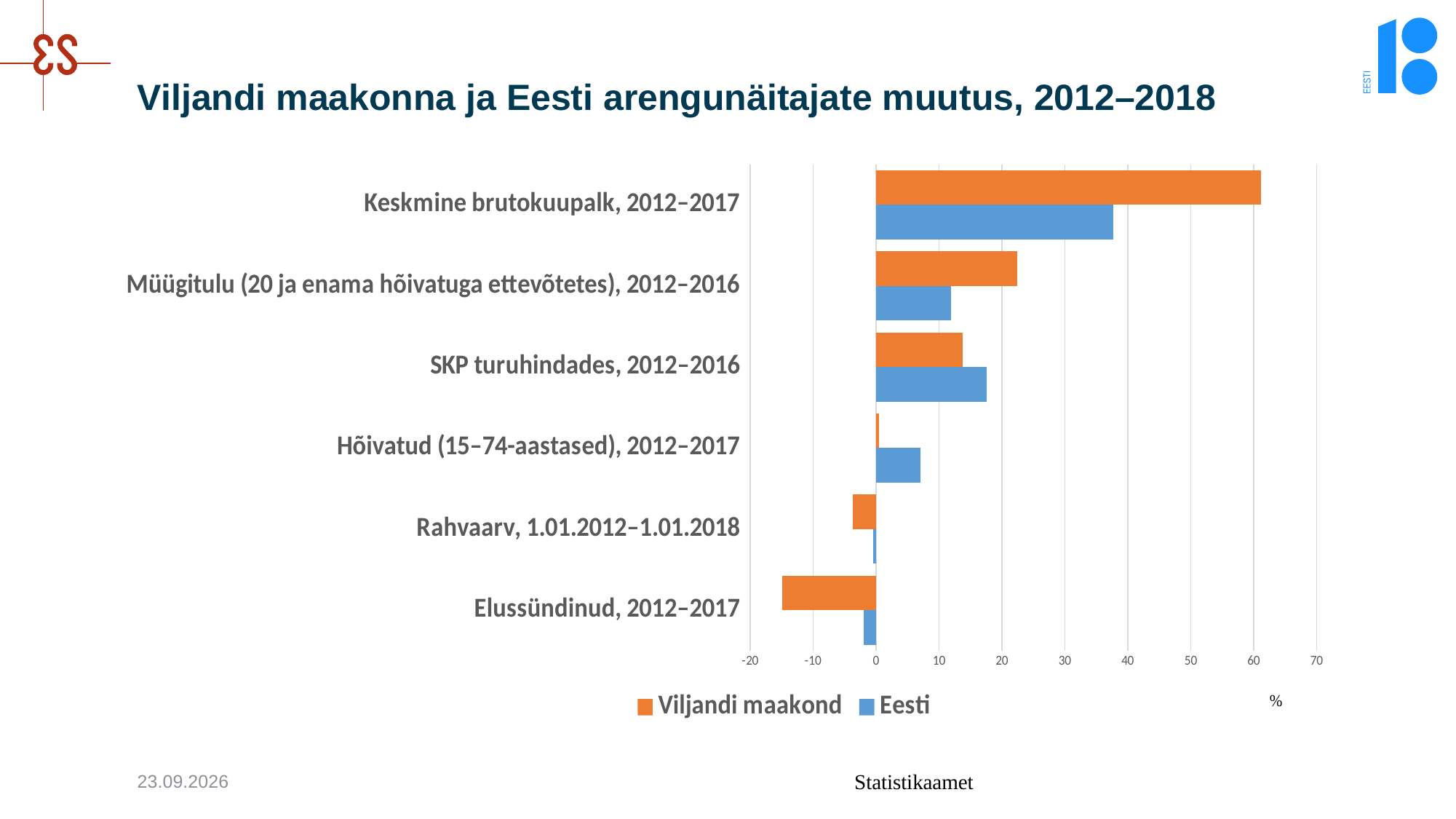
For the Eesti series, which category has the highest value? Keskmine brutokuupalk, 2012–2017 What kind of chart is shown on the slide? bar chart For the Viljandi maakond series, which category has the highest value? Keskmine brutokuupalk, 2012–2017 Is the Viljandi maakond value for Keskmine brutokuupalk, 2012–2017 greater or less than 50? greater Is the Viljandi maakond value for Elussündinud, 2012–2017 greater or less than -10? less For the Viljandi maakond series, which category has the lowest value? Elussündinud, 2012–2017 How many categories (indicators) are plotted on the chart? 6 How many series does the legend list? 2 Which colour represents the Eesti series in the legend? blue For Keskmine brutokuupalk, 2012–2017, which series has the larger value, Viljandi maakond or Eesti? Viljandi maakond Is the Eesti value for Keskmine brutokuupalk, 2012–2017 greater or less than 30? greater For SKP turuhindades, 2012–2016, which series has the larger value, Viljandi maakond or Eesti? Eesti